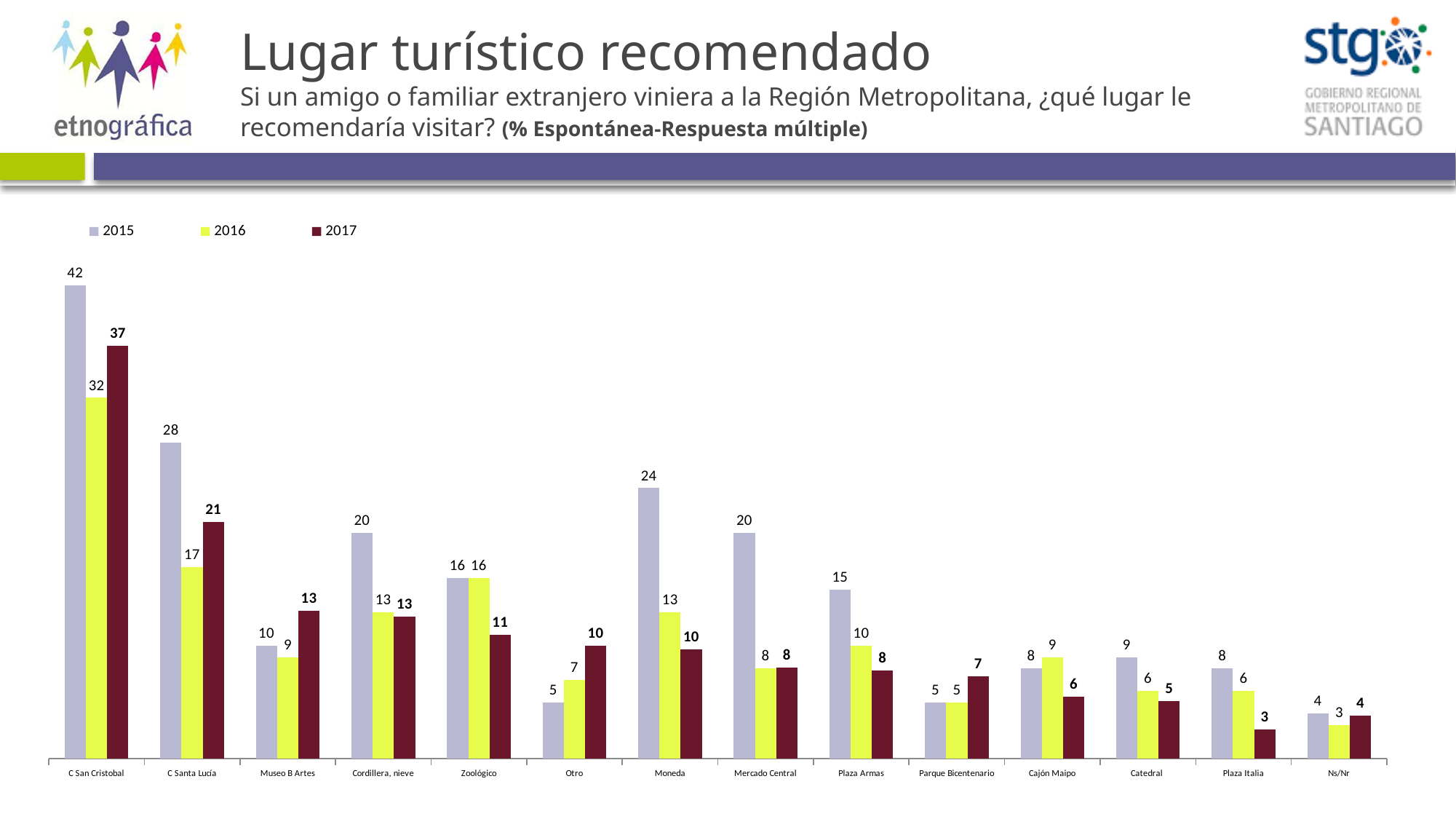
Which category has the lowest 2017 value? Plaza Italia How many categories are shown on the x axis? 14 Which category has the highest 2015 value? C San Cristobal What is the 2017 value for C San Cristobal? 37 What is the 2016 value for Cajón Maipo? 9 Which is larger for Otro: the 2015 value or the 2017 value? 2017 How many series does the legend list? 3 Which years are listed in the legend? 2015, 2016, 2017 What is the difference between the 2015 and 2017 values for C Santa Lucía? 7 What kind of chart is shown on the slide? Bar chart What is the 2015 value for Moneda? 24